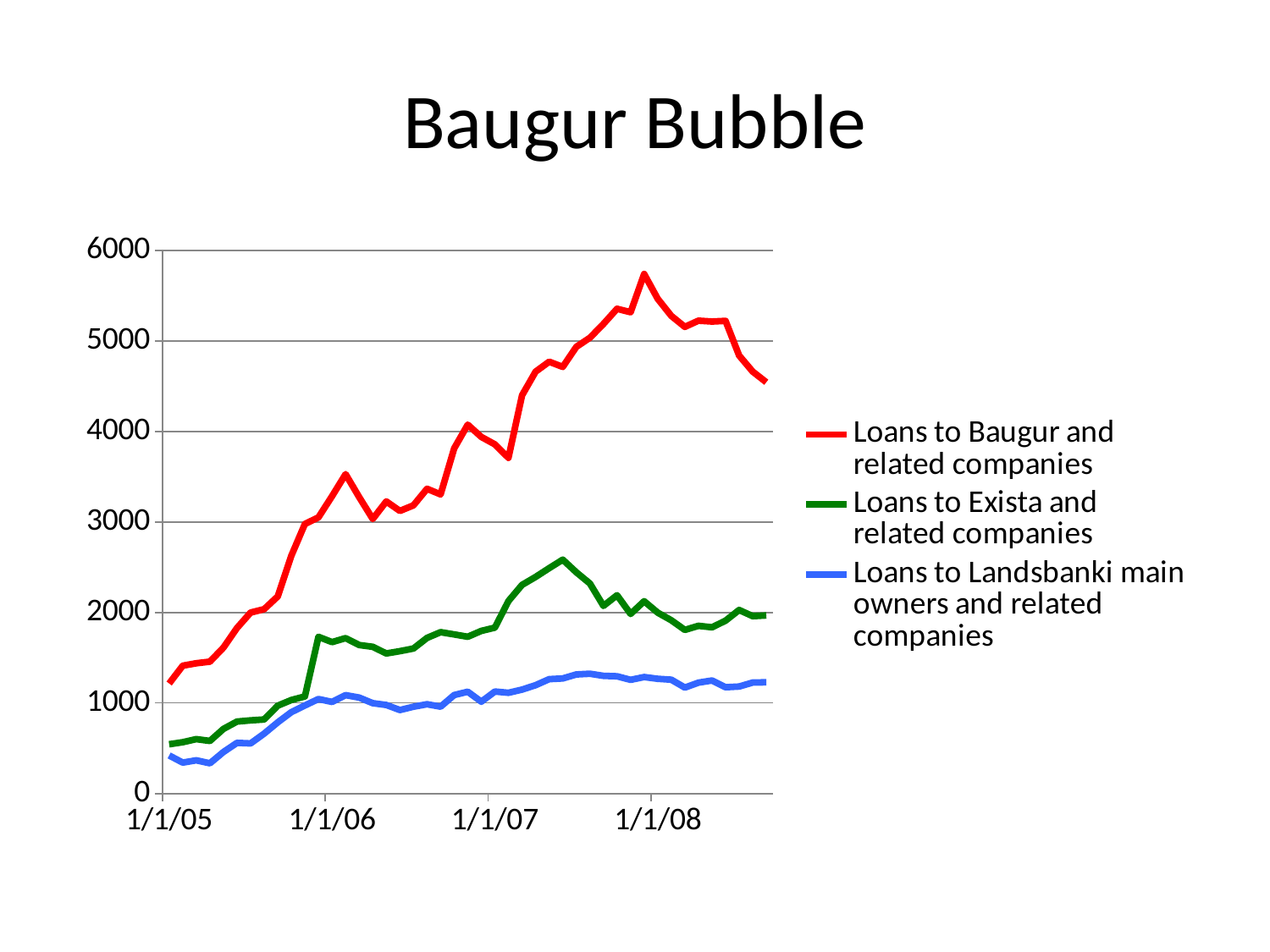
Is the highest value reached by Loans to Baugur and related companies greater or less than 5000? greater Is the value for Loans to Landsbanki main owners and related companies at 1/1/05 greater or less than 1000? less Which series has the highest values across the whole period? Loans to Baugur and related companies At 1/1/08, which is larger: Loans to Exista and related companies or Loans to Landsbanki main owners and related companies? Loans to Exista and related companies How many series does the legend list? 3 Is the value for Loans to Exista and related companies at 1/1/06 greater or less than 1000? greater Which series has the lowest value at 1/1/08? Loans to Landsbanki main owners and related companies What is the title of the chart? Baugur Bubble What kind of chart is shown on the slide? line chart Do the values for Loans to Baugur and related companies rise or fall from 1/1/05 to 1/1/08? rise What colour is the line for Loans to Landsbanki main owners and related companies? blue